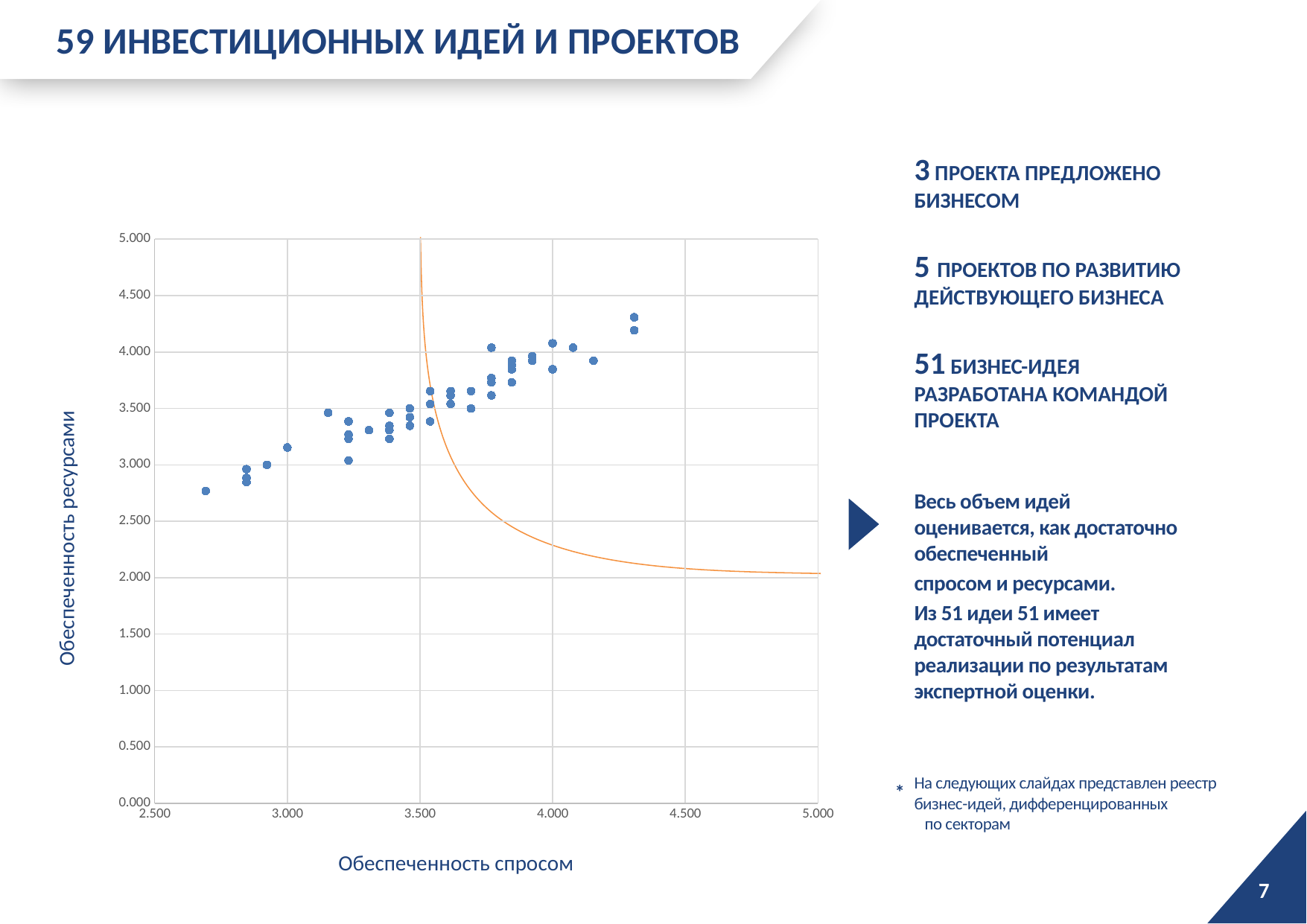
Is the x value of the rightmost blue point greater or less than 4.000? greater What kind of chart is shown on the slide? scatter chart Is the x value of the leftmost blue point greater or less than 3.000? less What is the label of the y axis of the chart? Обеспеченность ресурсами Is the y value of the orange curve at x = 5.000 greater or less than 2.500? less Do the blue points generally rise or fall as the x value (Обеспеченность спросом) increases? rise Which is larger: the y value of the rightmost blue point or the y value of the leftmost blue point? the rightmost blue point What is the label of the x axis of the chart? Обеспеченность спросом